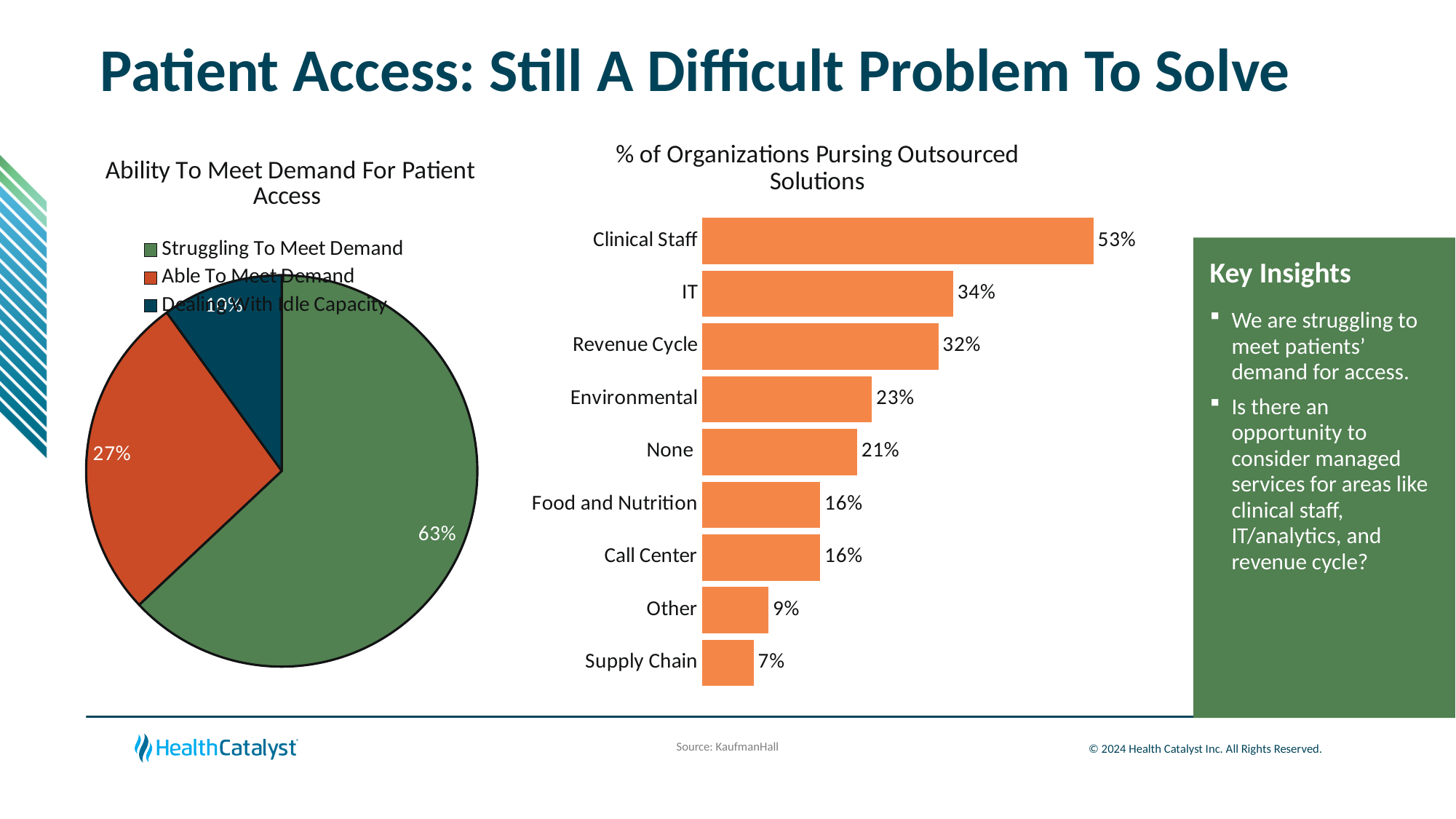
What kind of chart is the '% of Organizations Pursing Outsourced Solutions' chart? Bar chart In the 'Ability To Meet Demand For Patient Access' pie chart, what share is labelled for Struggling To Meet Demand? 63% In the '% of Organizations Pursing Outsourced Solutions' chart, which category has the lowest value? Supply Chain In the '% of Organizations Pursing Outsourced Solutions' chart, what is the value for Revenue Cycle? 32% In the '% of Organizations Pursing Outsourced Solutions' chart, how many categories are shown? 9 In the '% of Organizations Pursing Outsourced Solutions' chart, what is the value for Clinical Staff? 53% In the 'Ability To Meet Demand For Patient Access' pie chart, which slice is the smallest? Dealing With Idle Capacity In the 'Ability To Meet Demand For Patient Access' pie chart, how many slices are there? 3 In the '% of Organizations Pursing Outsourced Solutions' chart, which is larger, the value for None or the value for Other? None In the '% of Organizations Pursing Outsourced Solutions' chart, which category has the highest value? Clinical Staff In the '% of Organizations Pursing Outsourced Solutions' chart, what is the difference between the values for IT and Environmental? 11% In the 'Ability To Meet Demand For Patient Access' pie chart, what share is labelled for Able To Meet Demand? 27%